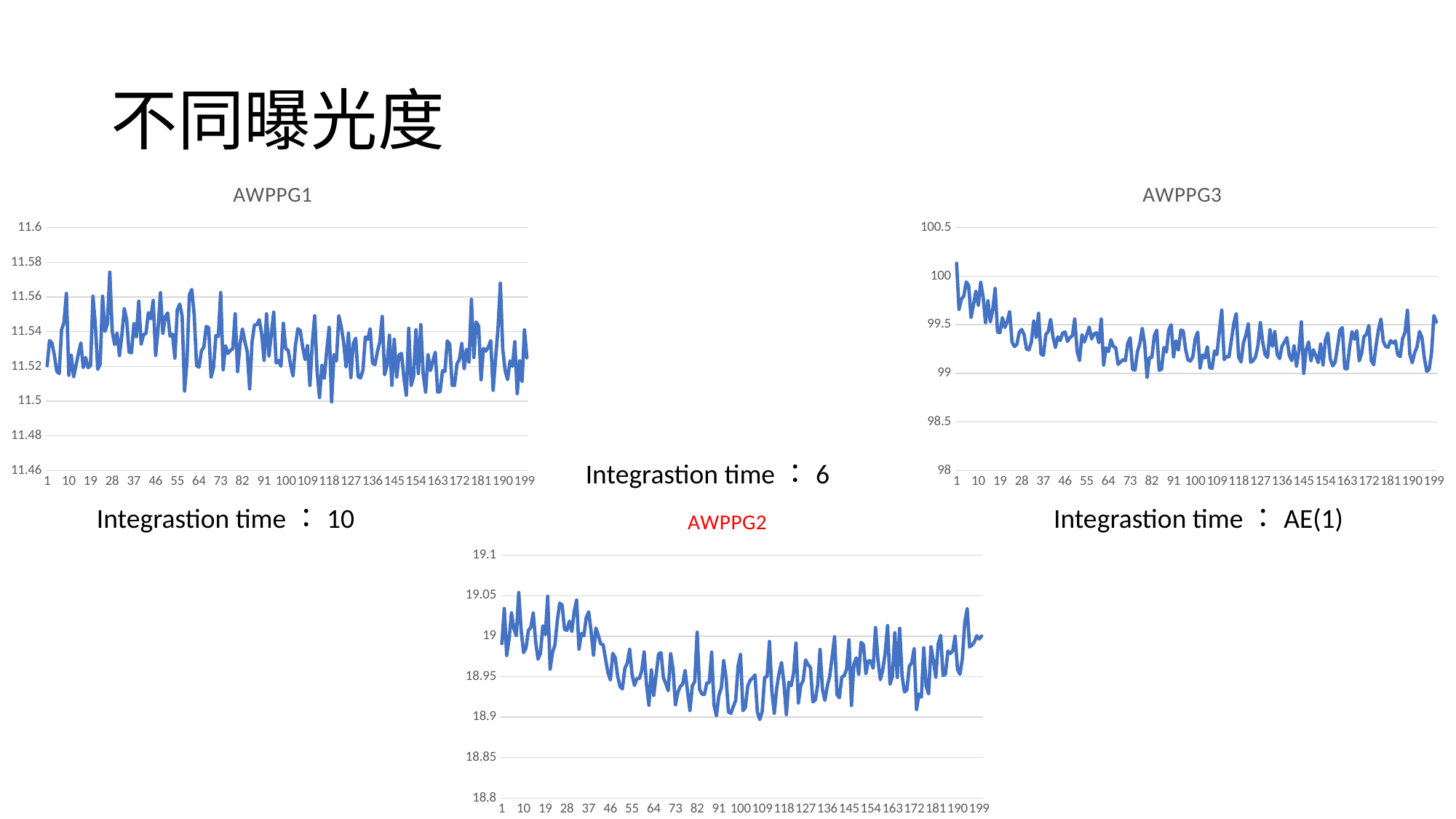
In the AWPPG2 chart, is the value at point 1 greater or less than 18.95? greater In the AWPPG3 chart, is the value at point 1 greater or less than 100? greater What is the highest value shown on the y axis of the AWPPG1 chart? 11.6 In the AWPPG3 chart, is the value at point 190 greater or less than 98.5? greater In the AWPPG3 chart, do the values generally rise or fall over the first 30 points? fall What kind of chart is the AWPPG3 chart? line chart What kind of chart is the AWPPG1 chart? line chart Which chart title on the slide is shown in red text? AWPPG2 In the AWPPG2 chart, do the values generally rise or fall between point 1 and point 100? fall